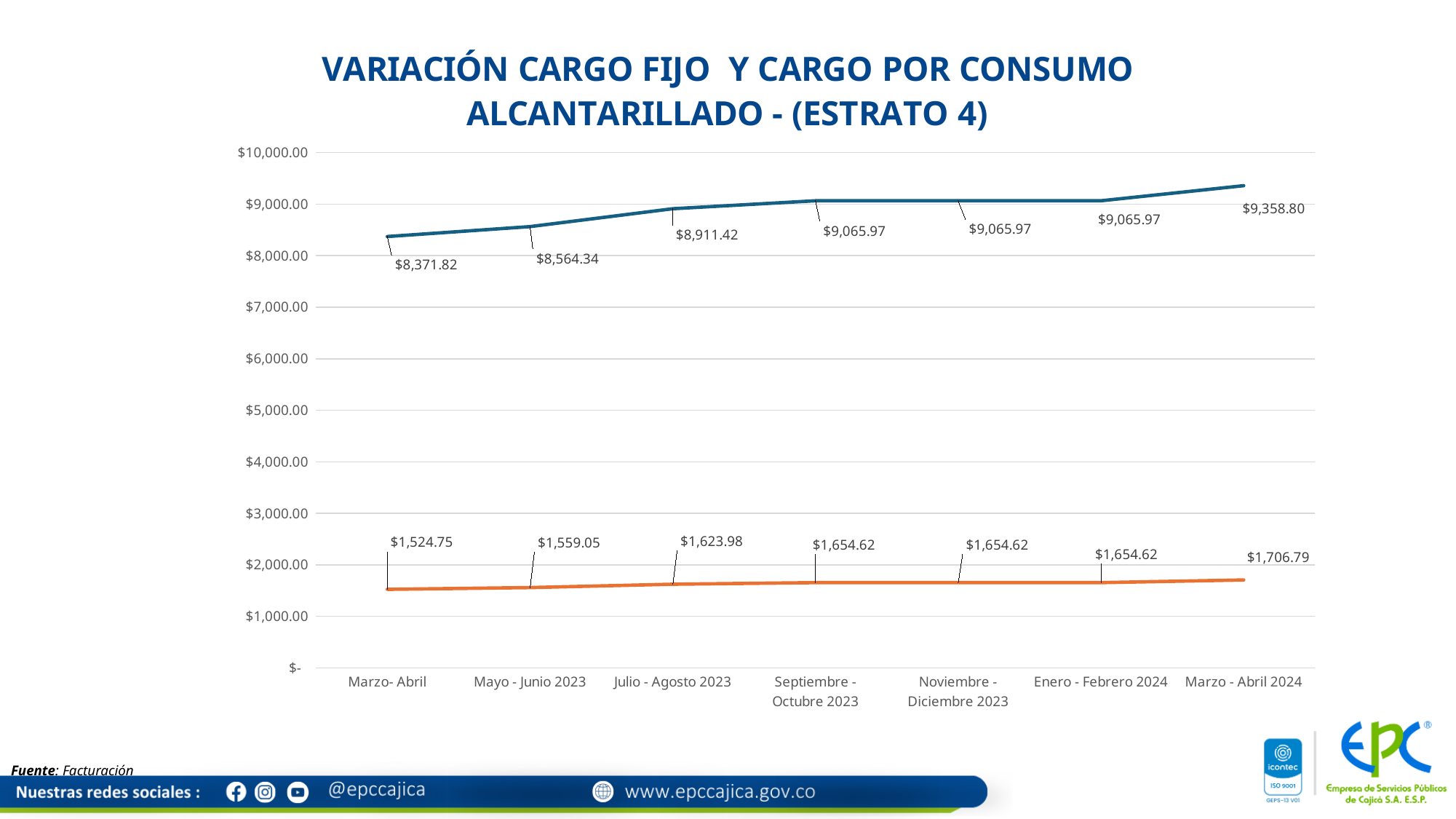
By how much did the upper blue line increase from Marzo- Abril to Marzo - Abril 2024? $986.98 In which period does the upper blue line reach its highest value? Marzo - Abril 2024 What type of chart is shown on the slide? Line chart What is the value of the lower orange line for Julio - Agosto 2023? $1,623.98 What is the value of the upper blue line for Marzo - Abril 2024? $9,358.80 What is the value of the lower orange line for Enero - Febrero 2024? $1,654.62 Do the values of the lower orange line rise or fall from left to right along the x axis? Rise What is the value of the upper blue line for Marzo- Abril (the first period)? $8,371.82 Which is larger: the upper blue line value for Mayo - Junio 2023 or for Julio - Agosto 2023? Julio - Agosto 2023 How many periods are shown on the x axis? 7 What is the difference between the upper blue line and the lower orange line in Marzo - Abril 2024? $7,652.01 In which period does the lower orange line have its lowest value? Marzo- Abril